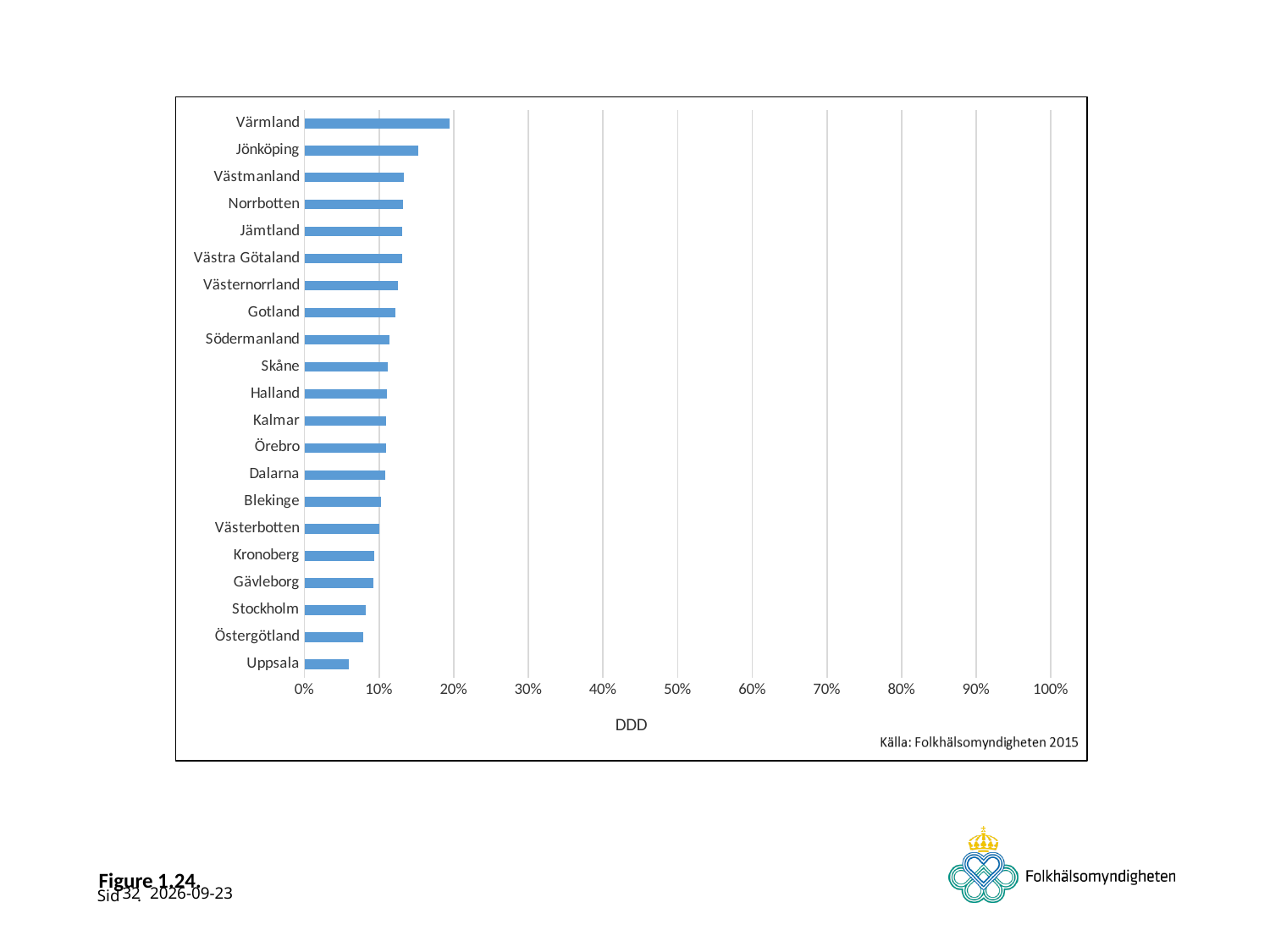
Which has the larger value, Jönköping or Stockholm? Jönköping Is the value for Värmland greater or less than 10%? greater How many regions (categories) are plotted in the chart? 21 Is the value for Jönköping greater or less than 20%? less Which region has the lowest value in the chart? Uppsala Which has the larger value, Värmland or Uppsala? Värmland Is the value for Stockholm greater or less than 10%? less What is the label on the horizontal axis of the chart? DDD Which region has the highest value in the chart? Värmland What kind of chart is shown on the slide? bar chart Do the bar values increase or decrease going from the top region (Värmland) to the bottom region (Uppsala)? decrease